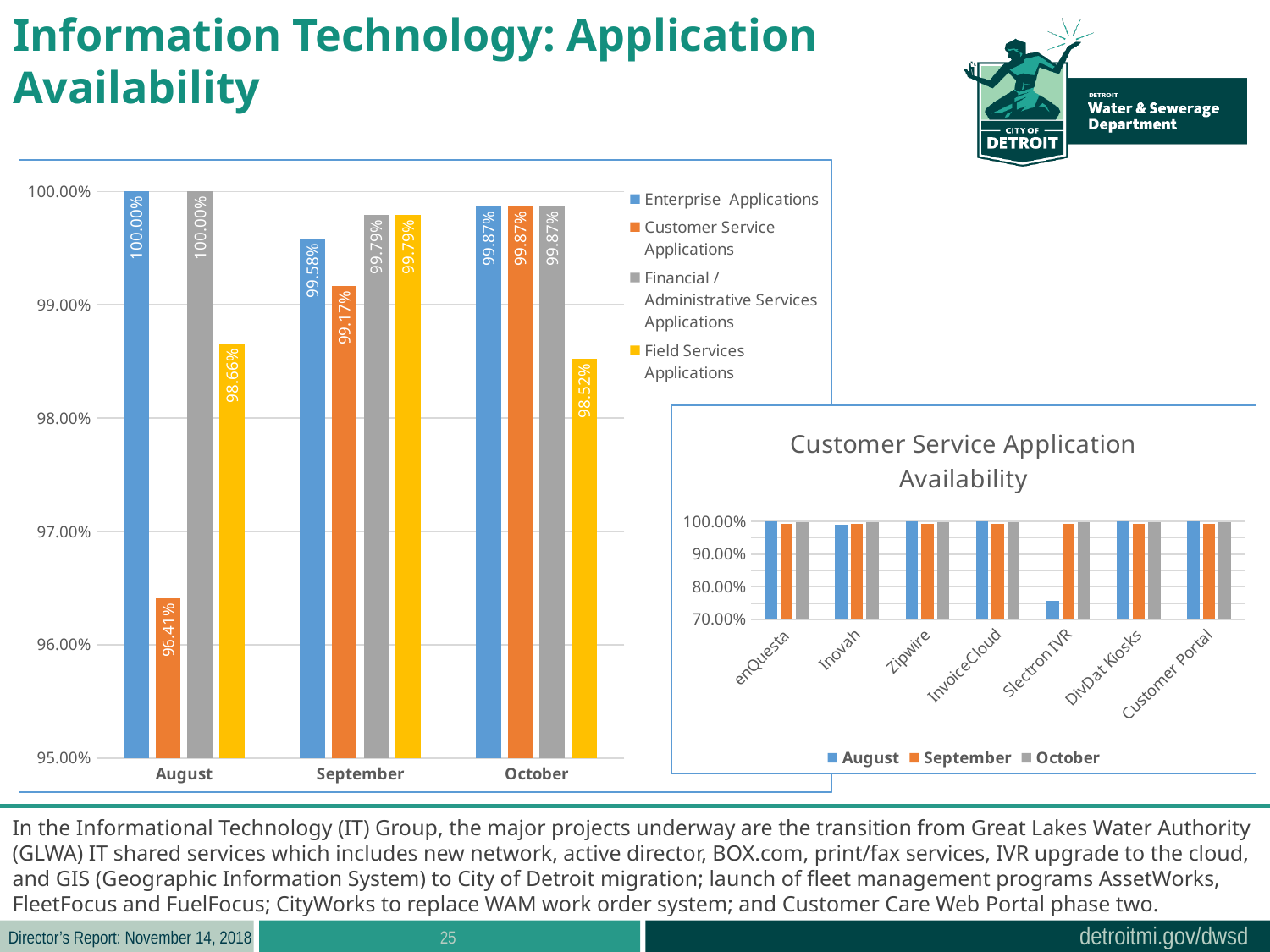
In the left chart, what is the difference between the Financial / Administrative Services Applications value and the Customer Service Applications value in September? 0.62% In the Customer Service Application Availability chart, which months does the legend list? August, September, October In the left chart, how does the Customer Service Applications value change from August to October? It rises In the Customer Service Application Availability chart, how many applications are shown on the x axis? 7 In the left chart, what is the value for Field Services Applications in October? 98.52% In the left chart, what is the value for Enterprise Applications in September? 99.58% In the left chart, which series has the lowest value in August? Customer Service Applications In the left chart, how many series does the legend list? 4 In the left chart, which is larger in October: Enterprise Applications or Field Services Applications? Enterprise Applications What kind of chart is the Customer Service Application Availability chart? Bar chart In the left chart, what is the value for Customer Service Applications in August? 96.41% In the Customer Service Application Availability chart, is the August value for Slectron IVR greater or less than 80.00%? less